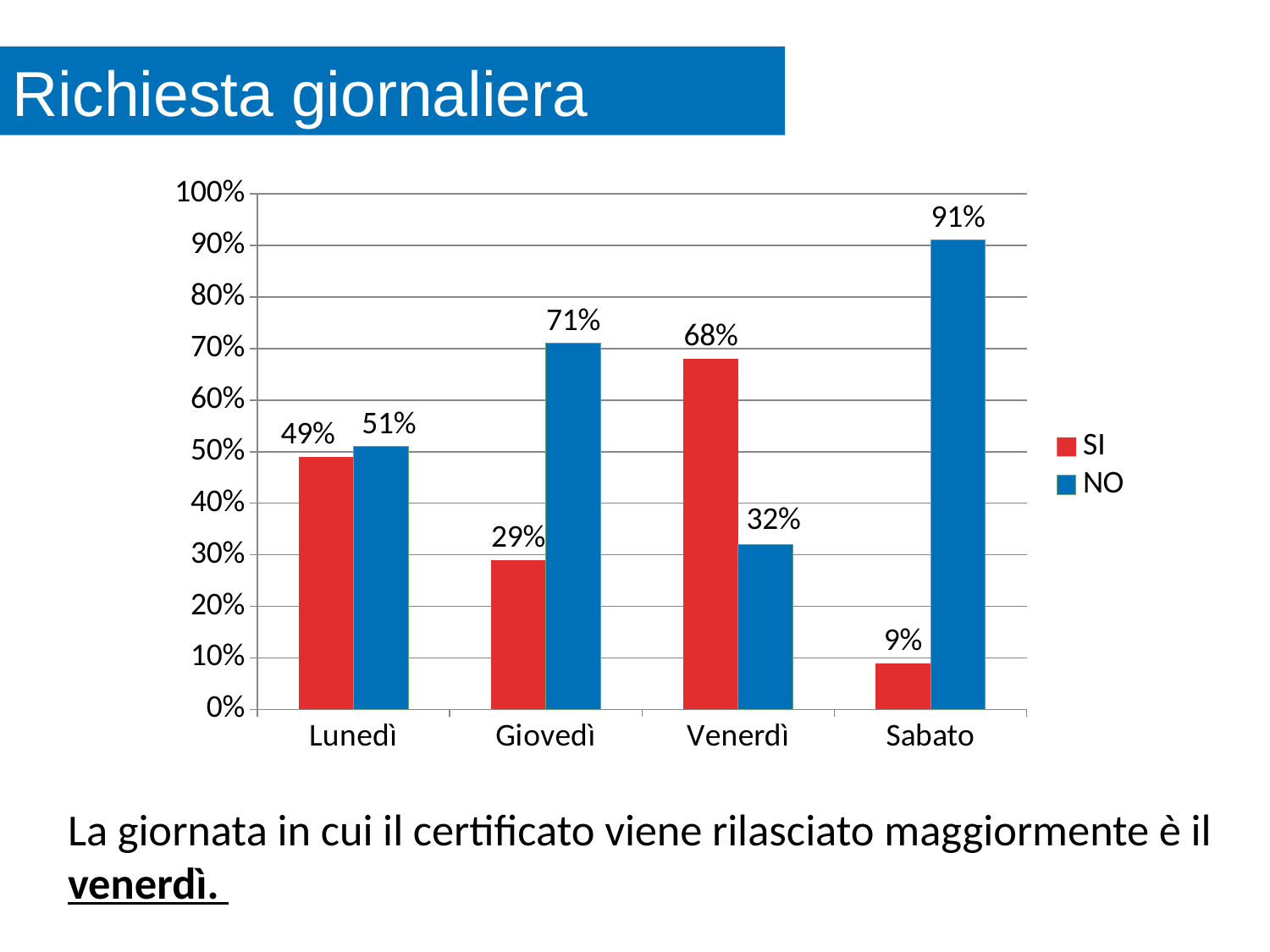
What is the difference between the NO and SI values for Giovedì? 42% What is the SI value for Venerdì? 68% What kind of chart is shown on the slide? Bar chart How many series does the legend list? 2 Which day has the highest SI value? Venerdì How many days are shown on the x axis? 4 Which day has the lowest SI value? Sabato Which day has the lowest NO value? Venerdì What is the NO value for Lunedì? 51% What is the SI value for Giovedì? 29% Which is larger for Sabato, the SI value or the NO value? NO What is the NO value for Sabato? 91%